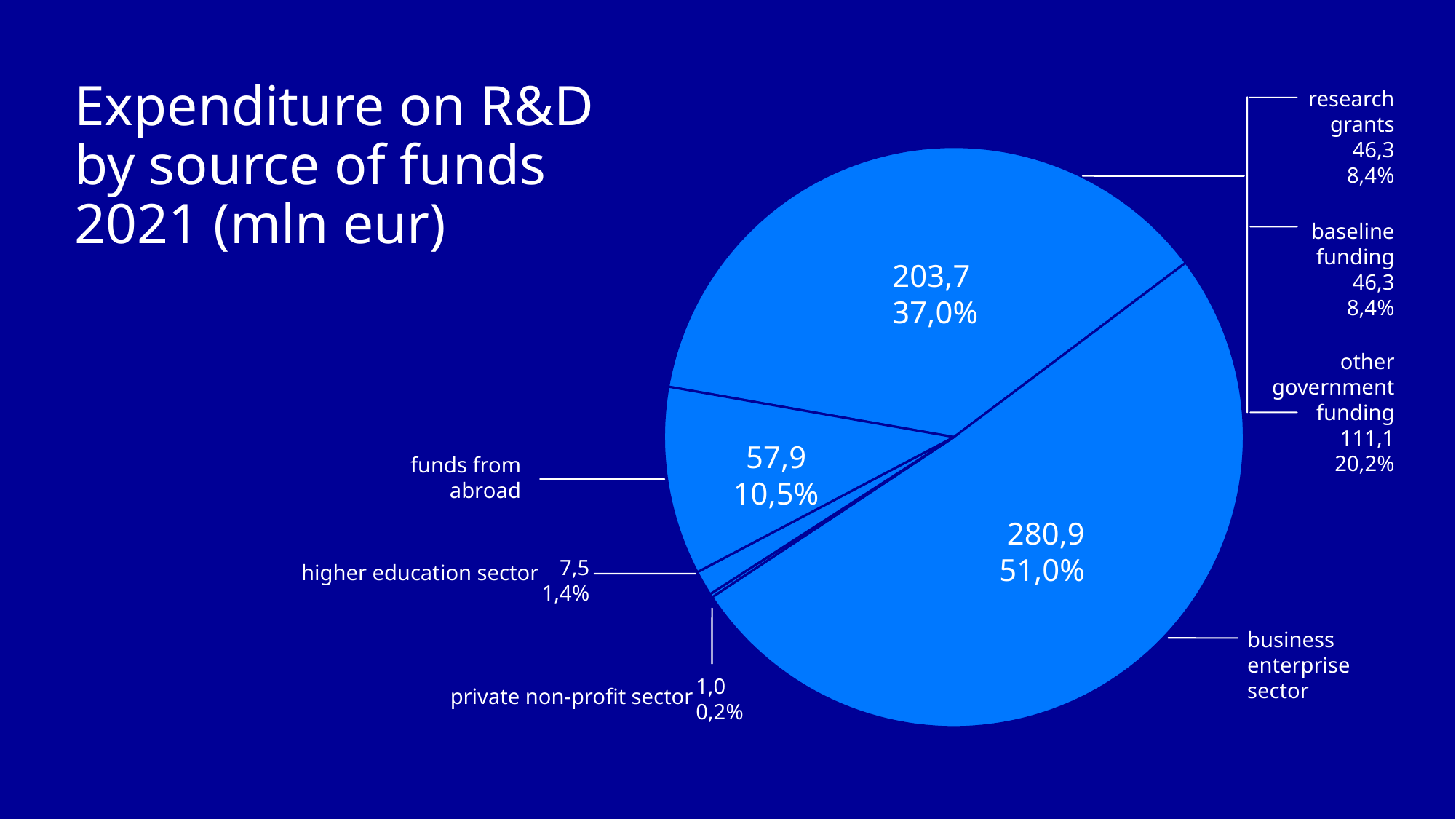
What is the value for the business enterprise sector? 280,9 Which is larger, research grants or other government funding? other government funding What is the value for the higher education sector? 7,5 What share of the pie does the private non-profit sector hold? 0,2% What share of the pie does the business enterprise sector hold? 51,0% What is the difference between the business enterprise sector (280,9) and funds from abroad (57,9)? 223,0 What share of the pie does funds from abroad hold? 10,5% What kind of chart is shown on the slide? pie chart Which source of funds has the largest slice? business enterprise sector What is the value for other government funding? 111,1 Which source of funds has the smallest slice? private non-profit sector What is the value for funds from abroad? 57,9